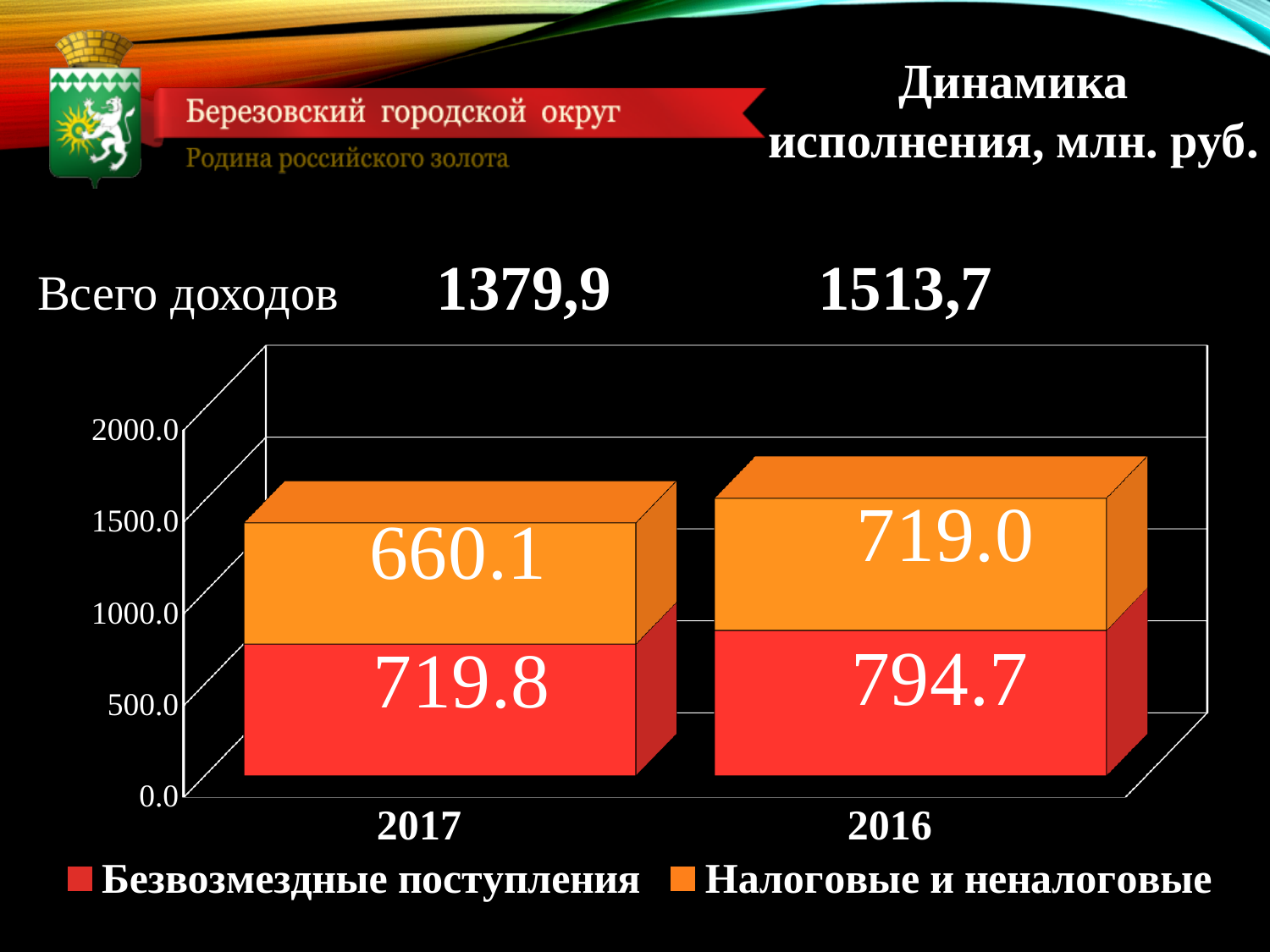
Which year has the higher value for Безвозмездные поступления? 2016 How many categories are shown on the x axis? 2 What is the value of Безвозмездные поступления for 2016? 794.7 What is the total of the stacked bar for 2016? 1513.7 What is the difference between the Безвозмездные поступления values for 2016 and 2017? 74.9 What is the value of Налоговые и неналоговые for 2016? 719.0 How many series does the legend list? 2 What is the difference between the Налоговые и неналоговые values for 2016 and 2017? 58.9 What is the value of Безвозмездные поступления for 2017? 719.8 What is the total of the stacked bar for 2017? 1379.9 What type of chart is shown on the slide? Stacked bar chart What is the value of Налоговые и неналоговые for 2017? 660.1